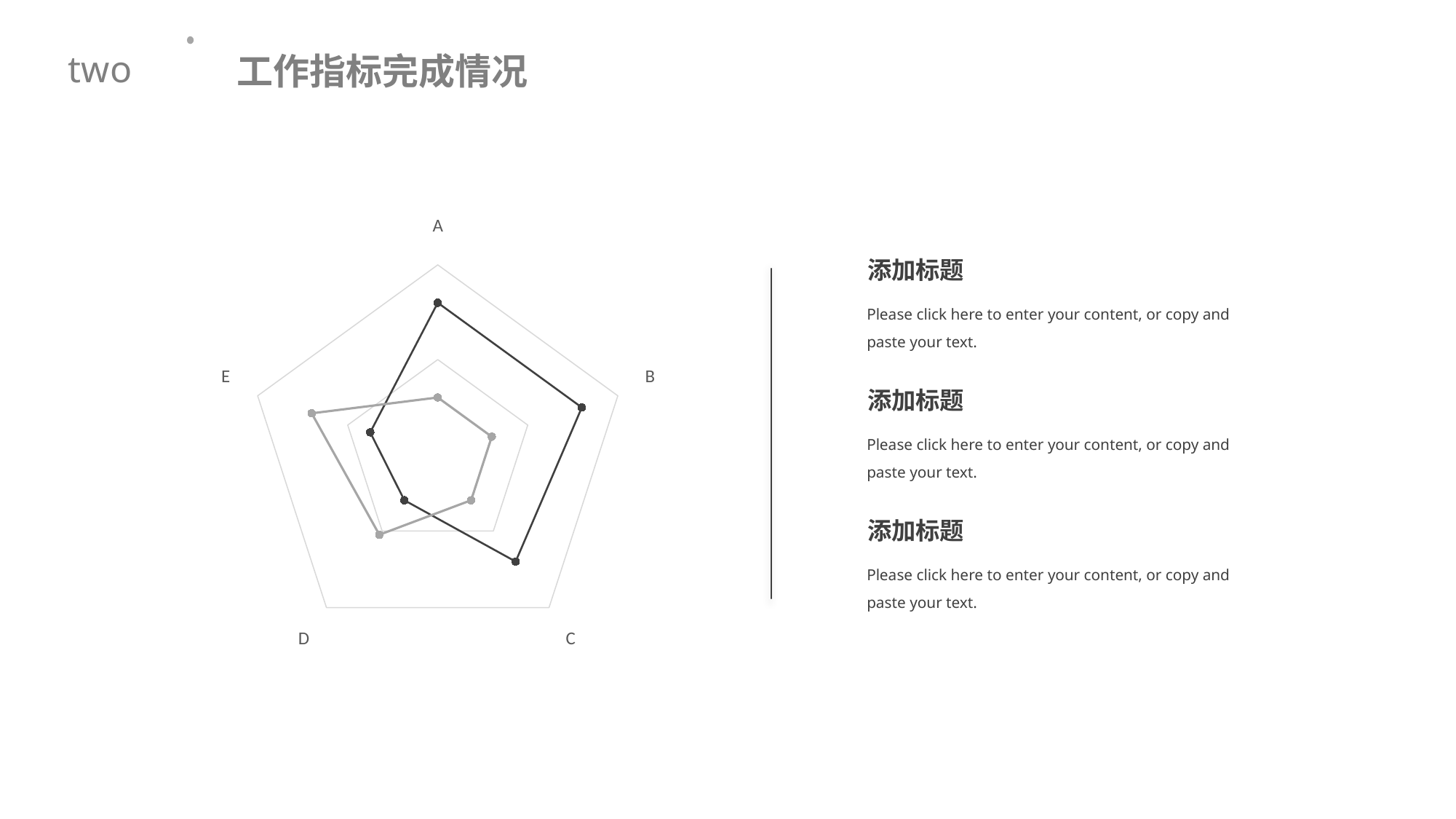
For the dark series, is its value on axis B larger or smaller than its value on axis E? Larger How many axes (categories) does the radar chart have? 5 How many data series are plotted on the radar chart? 2 What kind of chart is shown on the slide? Radar chart On axis C, which series has the larger value, the dark line or the light gray line? The dark line On axis B, which series has the larger value, the dark line or the light gray line? The dark line What is the title of the slide containing the radar chart? 工作指标完成情况 For the light gray series, on which axis is its value highest? E What are the category labels on the radar chart's axes? A, B, C, D, E